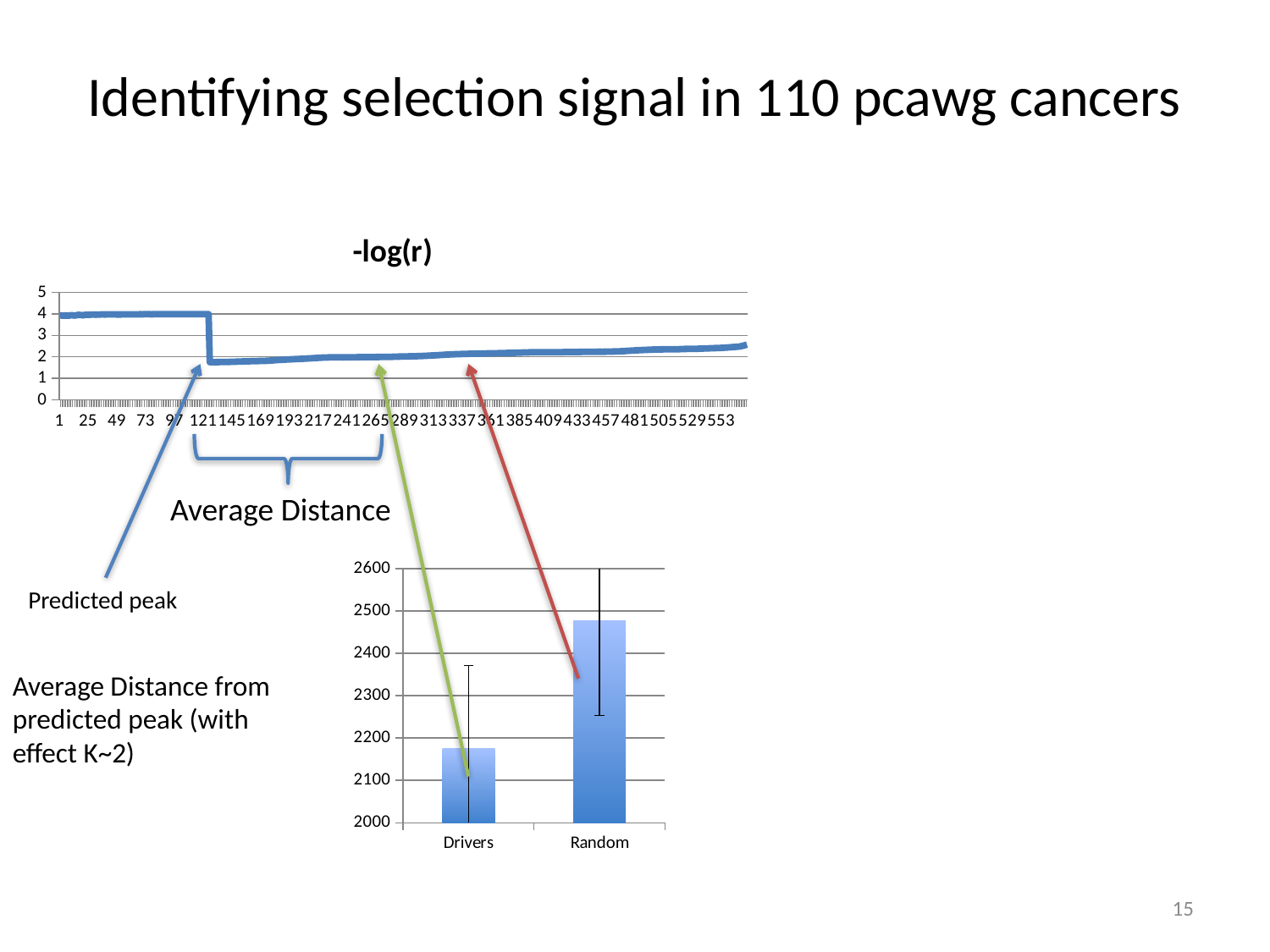
In the lower bar chart, is the value for Random greater or less than 2500? less In the chart titled "-log(r)", is the value at x = 1 greater or less than 3? greater What type of chart is the chart titled "-log(r)"? line chart In the lower bar chart, is the value for Drivers greater or less than 2300? less What is the title of the upper chart? -log(r) In the lower bar chart, how many categories are shown on the x axis? 2 What type of chart is the lower chart with the categories Drivers and Random? bar chart In the chart titled "-log(r)", what is the highest value shown on the y axis? 5 In the lower bar chart, which category has the lowest bar? Drivers In the lower bar chart, which category has the higher bar, Drivers or Random? Random